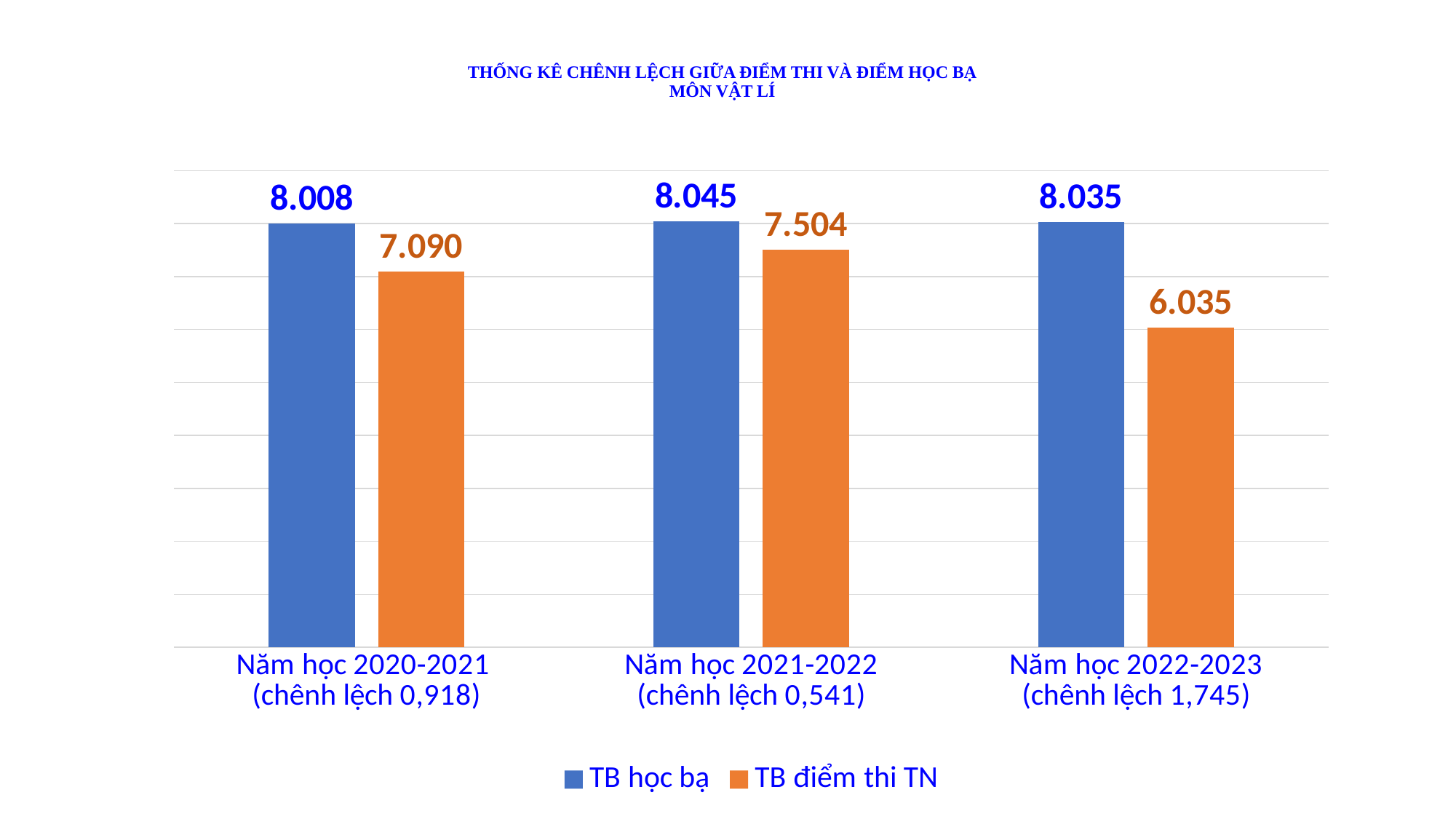
What is the value of TB điểm thi TN for Năm học 2021-2022? 7.504 What is the difference between TB học bạ and TB điểm thi TN for Năm học 2021-2022? 0.541 Does the TB điểm thi TN value rise or fall from Năm học 2021-2022 to Năm học 2022-2023? Fall Which school year has the lowest TB điểm thi TN value? Năm học 2022-2023 What is the value of TB học bạ for Năm học 2020-2021? 8.008 Which is larger for Năm học 2022-2023: TB học bạ or TB điểm thi TN? TB học bạ What is the value of TB điểm thi TN for Năm học 2022-2023? 6.035 How many school years are shown on the x axis? 3 What is the difference between TB học bạ and TB điểm thi TN for Năm học 2020-2021? 0.918 What kind of chart is shown on the slide? Bar chart How many series does the legend list? 2 Which school year has the highest TB học bạ value? Năm học 2021-2022